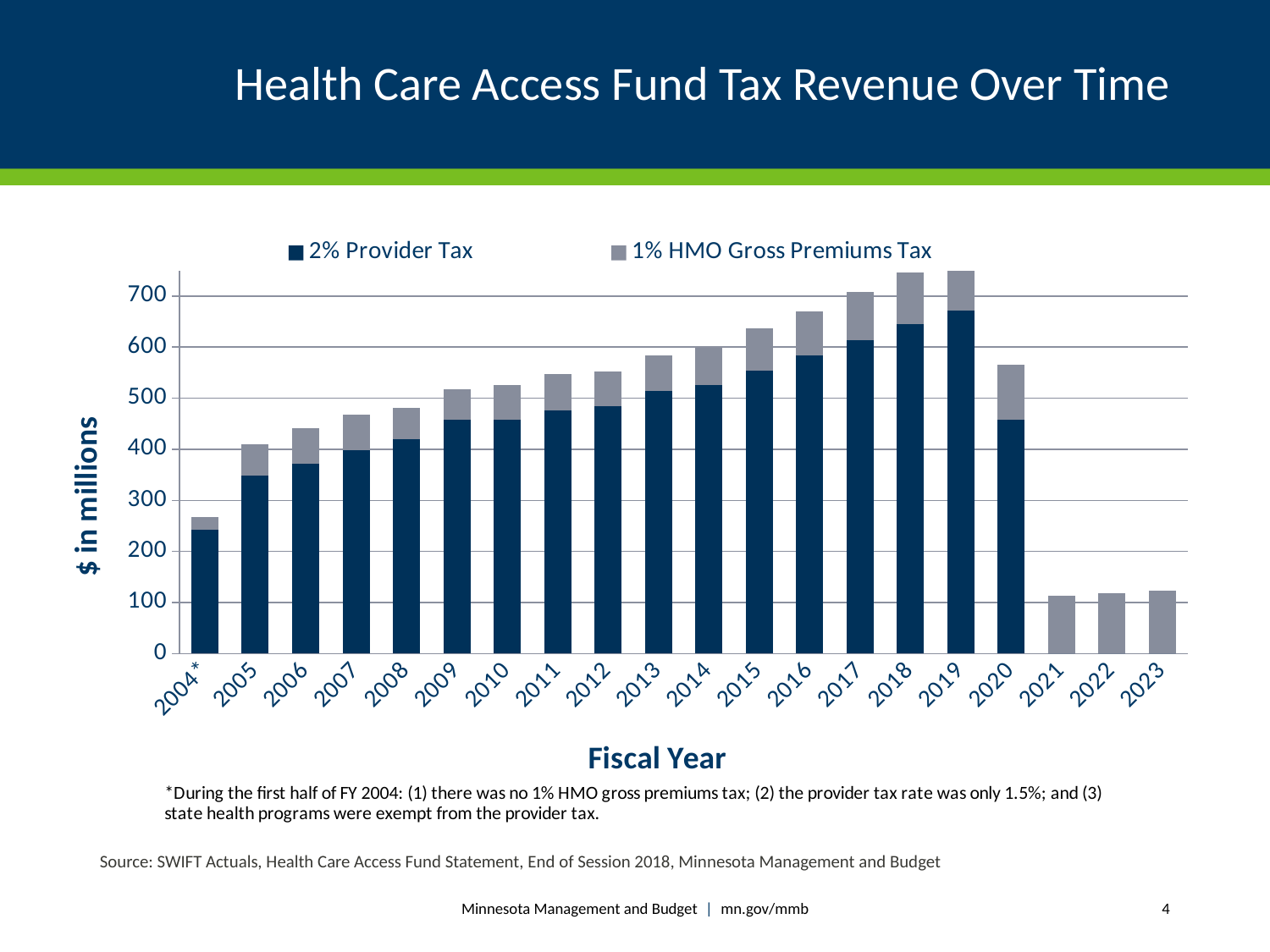
Is the total value for fiscal year 2008 greater or less than 500? less Do the total values rise or fall from fiscal year 2004* to fiscal year 2019? Rise Which fiscal year has the larger total, 2020 or 2021? 2020 Is the total value for fiscal year 2004* greater or less than 300? less Is the total value for fiscal year 2020 greater or less than 500? greater How many series does the legend list? 2 What kind of chart is shown on the slide? Stacked bar chart How many fiscal years are shown on the x axis? 20 What is the title of the y axis? $ in millions